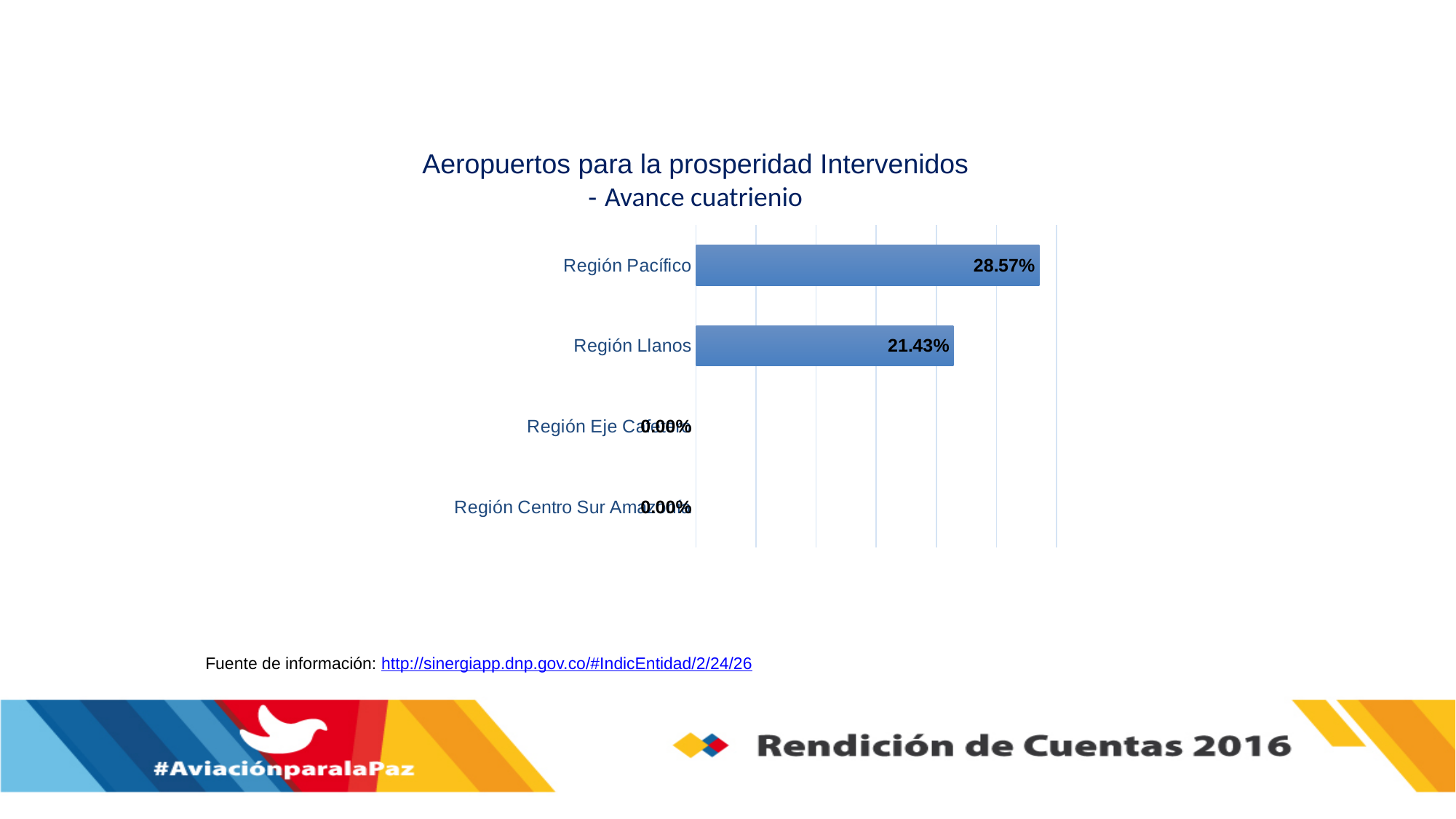
How many regions are shown in the chart? 4 Which region has the highest value? Región Pacífico How many regions have a value of 0.00%? 2 What kind of chart is shown on the slide? Bar chart Which region is listed at the top of the chart? Región Pacífico What is the difference between the values for Región Pacífico and Región Llanos? 7.14% What is the value for Región Llanos? 21.43% What colour are the bars in the chart? Blue What is the value for Región Pacífico? 28.57% What is the title of the chart? Aeropuertos para la prosperidad Intervenidos - Avance cuatrienio Which is larger, the value for Región Pacífico or the value for Región Llanos? Región Pacífico